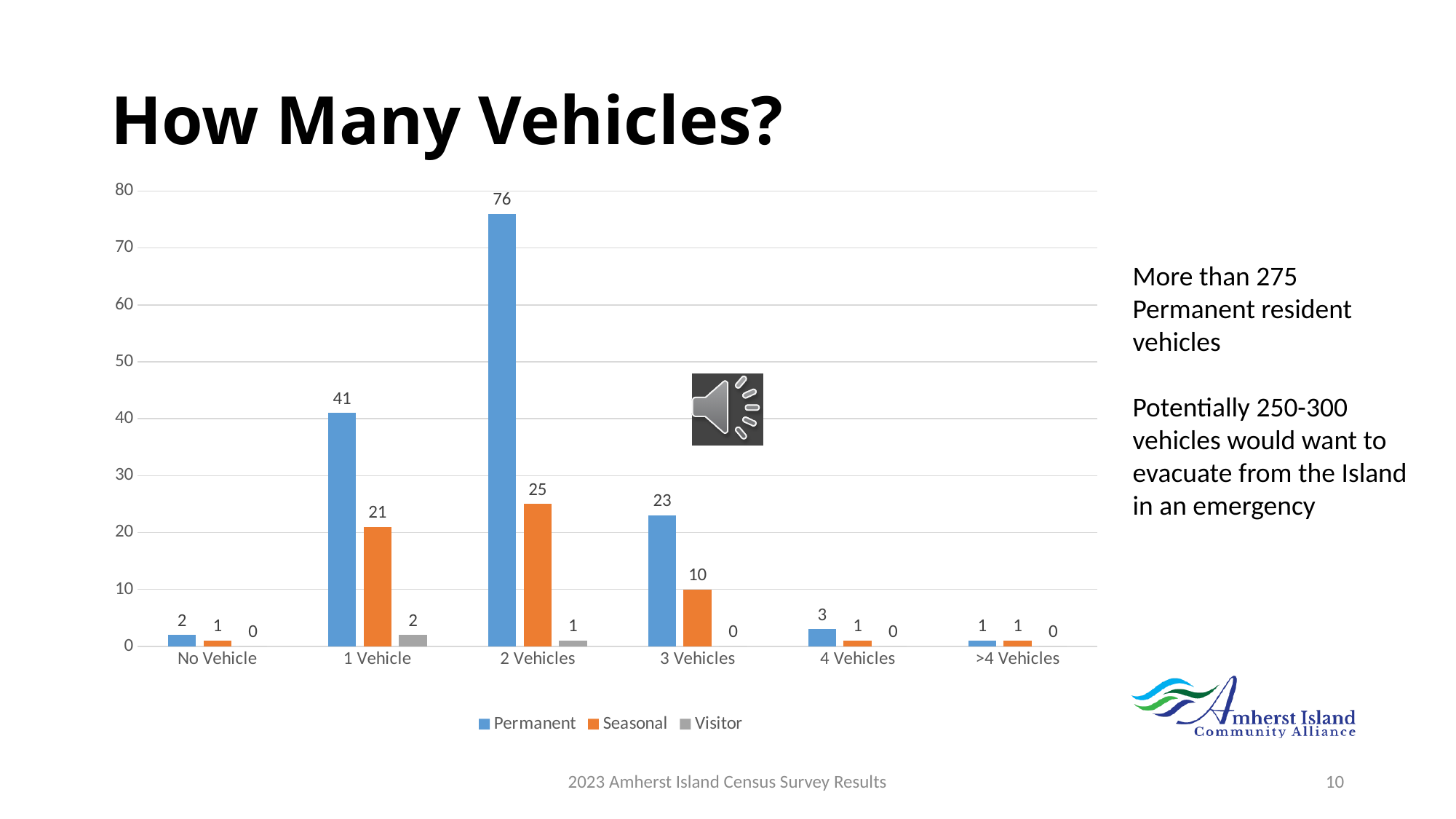
What kind of chart is shown on the slide? bar chart Which is larger, the Permanent value for 1 Vehicle or the Seasonal value for 2 Vehicles? Permanent value for 1 Vehicle Which category has the lowest Seasonal value? No Vehicle, 4 Vehicles and >4 Vehicles (all 1) What is the Seasonal value for 1 Vehicle? 21 What is the Visitor value for No Vehicle? 0 Is the Permanent value for 2 Vehicles greater or less than 70? greater How many series does the legend list? 3 What is the Permanent value for 2 Vehicles? 76 How many categories are shown on the x axis? 6 What is the difference between the Permanent and Seasonal values for 3 Vehicles? 13 Which category has the highest Permanent value? 2 Vehicles What colour represents the Seasonal series? orange